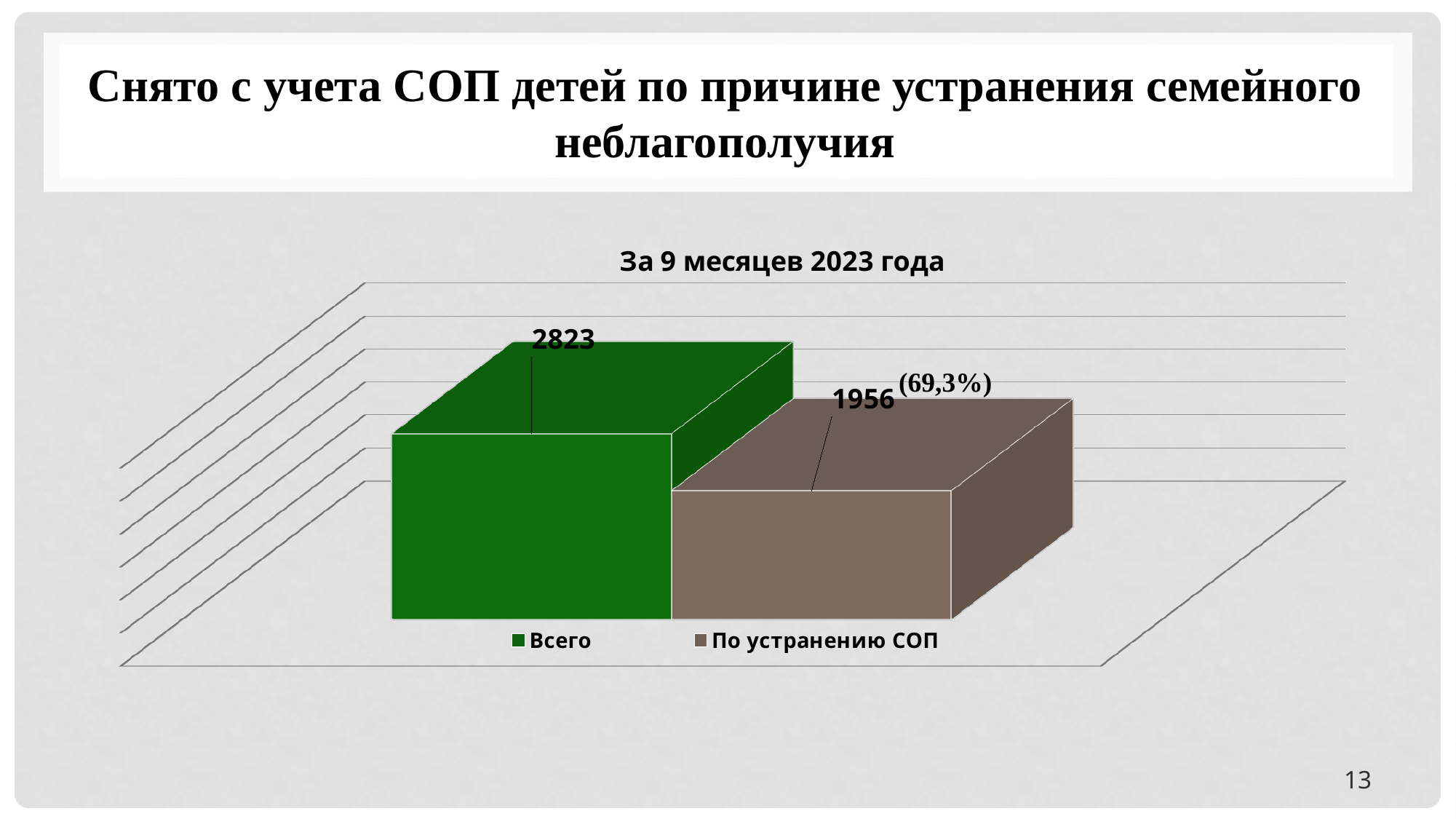
What is the difference between the values for Всего and По устранению СОП? 867 How many series does the legend list? 2 What is the value for Всего? 2823 What is the title of the chart? За 9 месяцев 2023 года What kind of chart is shown on the slide? bar chart What is the value for По устранению СОП? 1956 Which series has the lowest value? По устранению СОП What percentage is shown next to the value for По устранению СОП? 69,3% Which is larger, the value for Всего or the value for По устранению СОП? Всего What colour is the bar for Всего? green Which series has the highest value? Всего